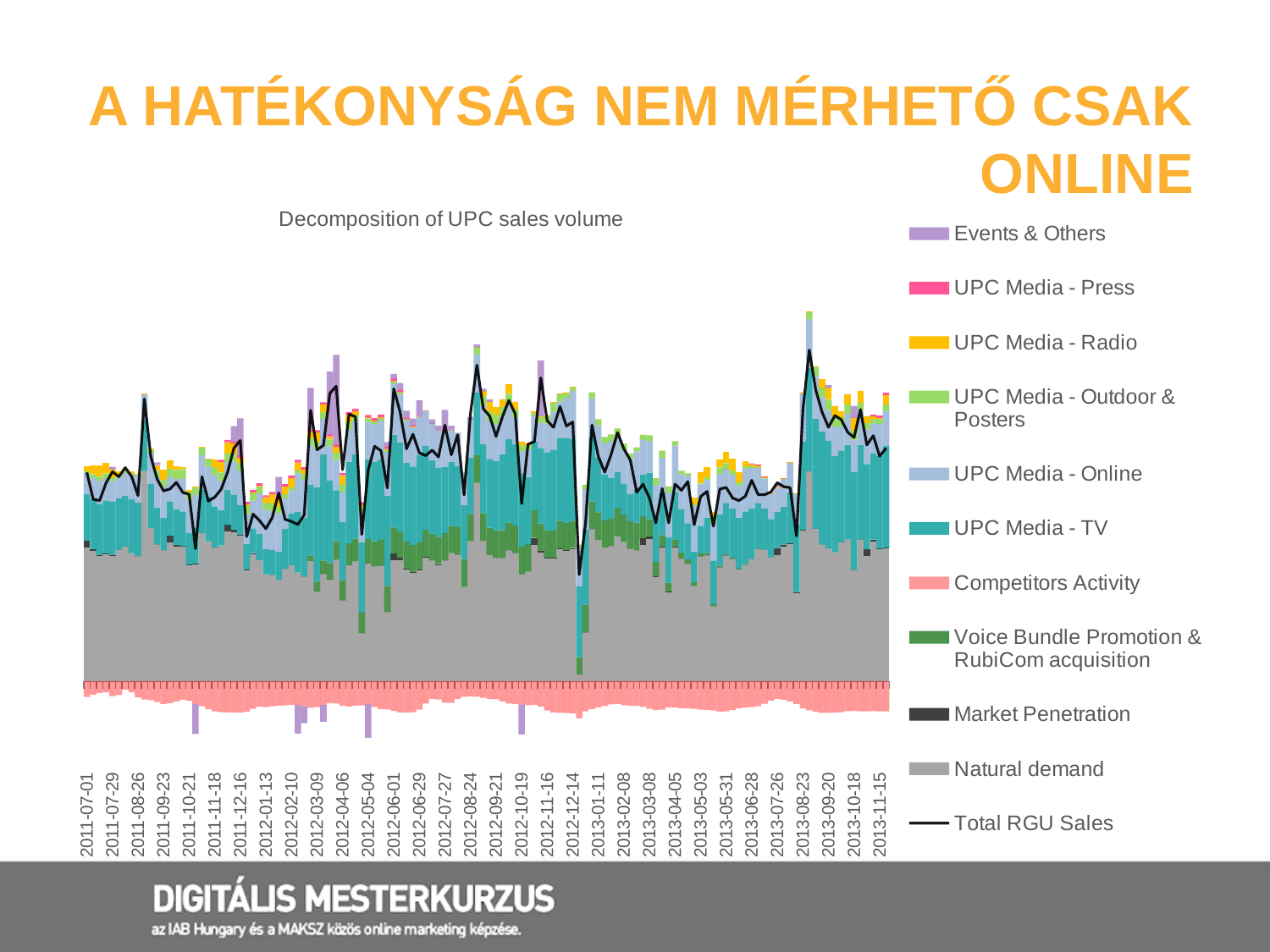
Which series is drawn as a black line rather than as stacked bars? Total RGU Sales What is the last date label on the x axis? 2013-11-15 Is Total RGU Sales higher at 2013-08-23 or at 2011-07-01? 2013-08-23 How many entries does the legend of the chart list? 11 What kind of chart is shown on the slide? Stacked bar chart with a line Around which x-axis date does the Total RGU Sales line drop to its lowest point? 2012-12-14 What is the title of the chart? Decomposition of UPC sales volume Which series forms the largest part of each stacked bar? Natural demand What is the first date label on the x axis? 2011-07-01 How many date labels are shown along the x axis? 32 Around which x-axis date does the Total RGU Sales line reach its highest peak? 2013-08-23 Which series is plotted consistently below the horizontal axis as negative values? Competitors Activity